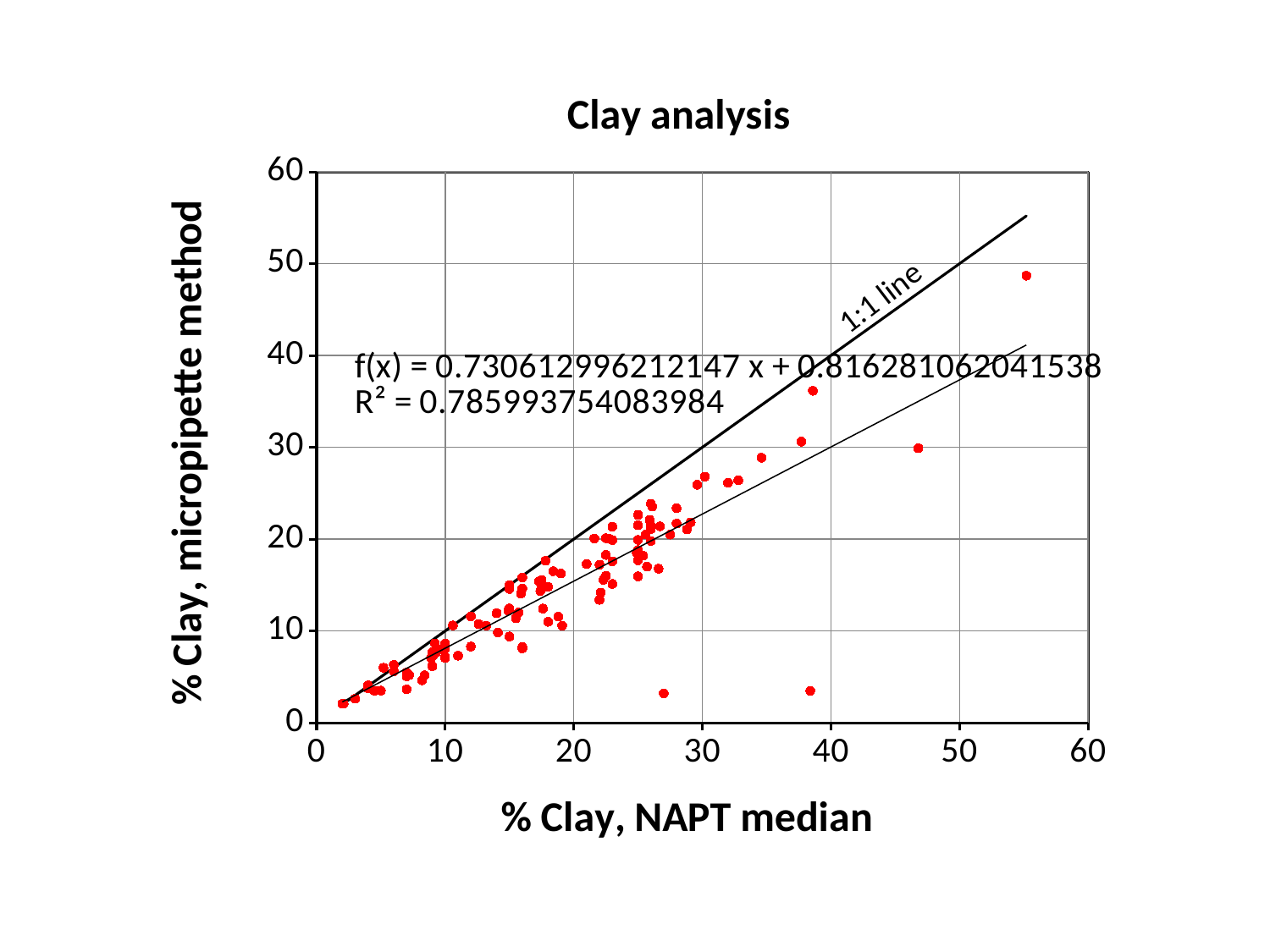
What kind of chart is shown on the slide? scatter plot Do the micropipette values generally rise or fall as the NAPT median increases along the x axis? rise What is the maximum value shown on the y axis? 60 Is the micropipette value of the outlier point near NAPT median 38 at the bottom of the chart greater or less than 10? less What is the slope of the fitted line f(x) printed on the chart? 0.730612996212147 What is the label of the x axis? % Clay, NAPT median Is the micropipette value of the point with the highest NAPT median (around 55) greater or less than 40? greater What R² value is printed on the chart? 0.785993754083984 What is the intercept of the fitted line f(x) printed on the chart? 0.816281062041538 What is the title of the chart? Clay analysis Is the micropipette value of the point near NAPT median 47 greater or less than 40? less Does the fitted regression line lie above or below the 1:1 line at NAPT median 50? below